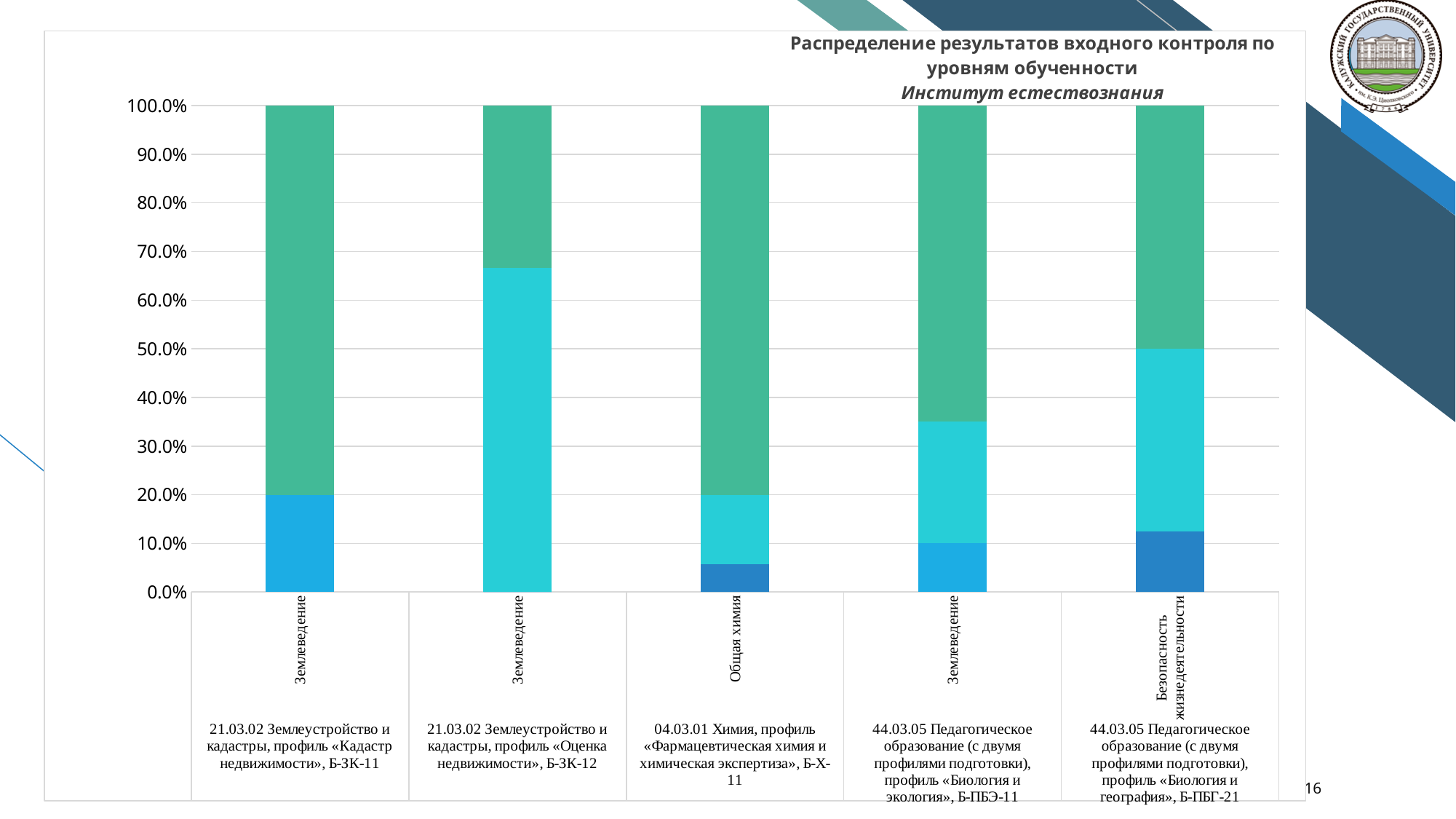
Which bar has the largest cyan segment? 21.03.02 Землеустройство и кадастры, профиль «Оценка недвижимости», Б-ЗК-12 How many programme groups (categories) are shown on the x axis of the chart? 5 Which institute is named in the chart's subtitle? Институт естествознания For the Б-ПБГ-21 bar, is the top of the cyan segment greater or less than 40%? greater For the Б-ЗК-12 bar, is the boundary between the cyan and green segments greater or less than 60%? greater What kind of chart is shown on the slide? Stacked bar chart For the Б-ПБЭ-11 bar, is the top of the cyan segment greater or less than 30%? greater Which bar has the smallest green segment? 21.03.02 Землеустройство и кадастры, профиль «Оценка недвижимости», Б-ЗК-12 Which bar has the larger blue (bottom) segment: Б-ЗК-11 or Б-ПБЭ-11? Б-ЗК-11 What is the title of the chart? Распределение результатов входного контроля по уровням обученности